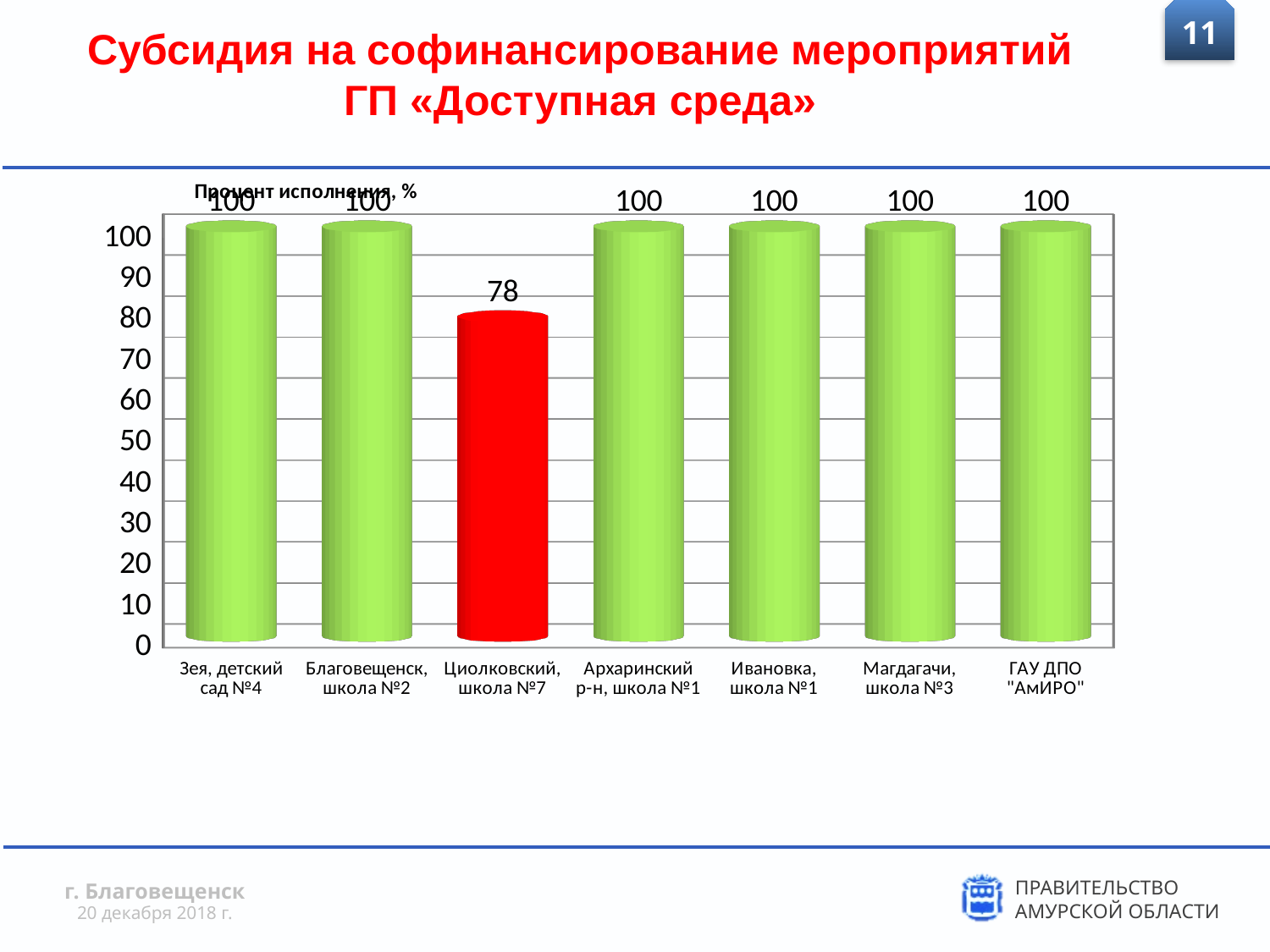
How many categories have a value of 100? 6 Which category has the lowest value? Циолковский, школа №7 What is the label shown above the chart's plot area? Процент исполнения, % Is the value for Циолковский, школа №7 greater or less than 80? less How many categories are shown on the chart? 7 What kind of chart is shown on the slide? bar chart What is the difference between the value for Благовещенск, школа №2 and the value for Циолковский, школа №7? 22 What is the value for Зея, детский сад №4? 100 Which is larger: the value for Ивановка, школа №1 or the value for Циолковский, школа №7? Ивановка, школа №1 What is the value for ГАУ ДПО "АмИРО"? 100 What is the value for Циолковский, школа №7? 78 Which bar is coloured red? Циолковский, школа №7